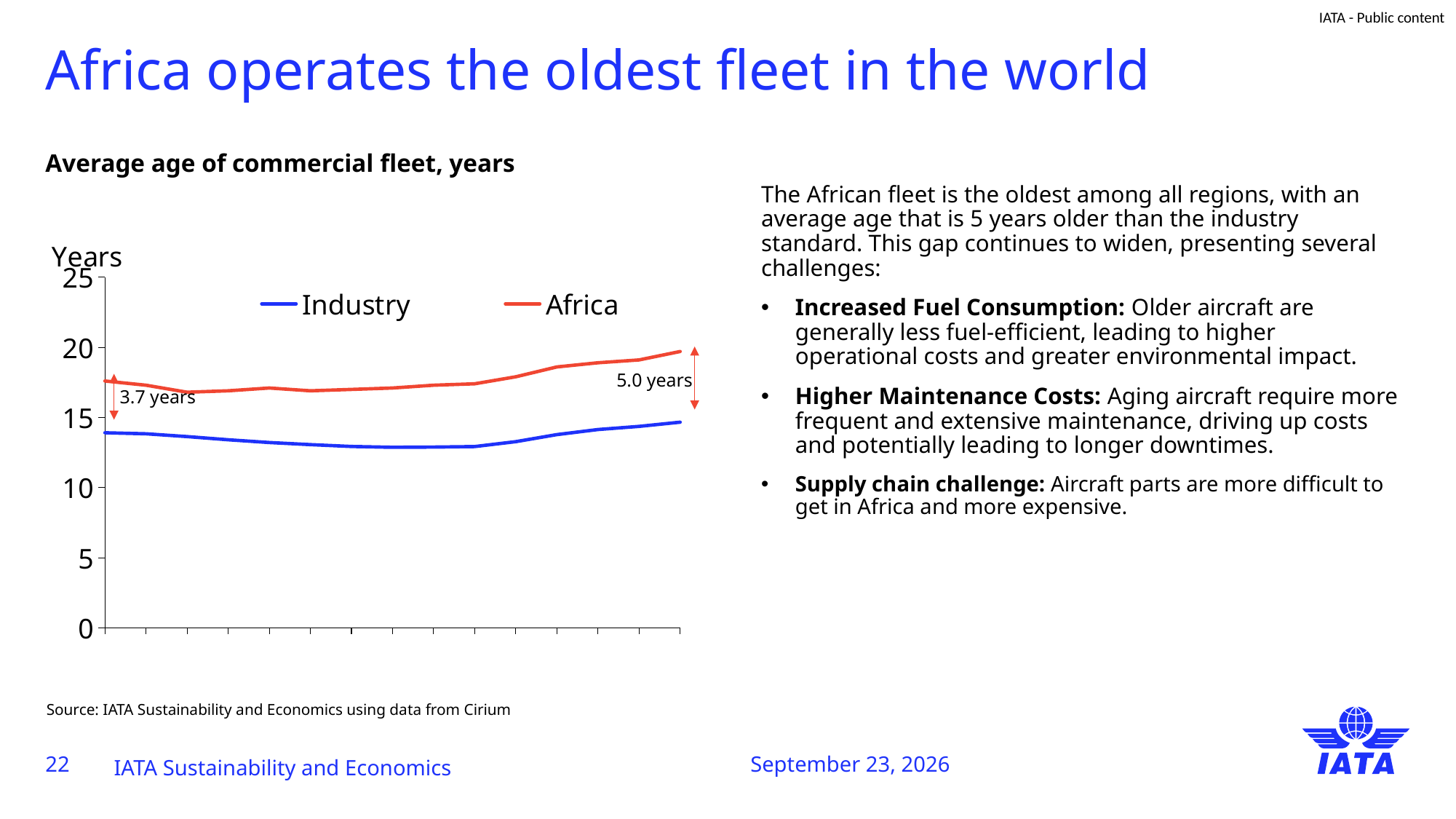
Is the value for Africa at the right end of the chart greater or less than 15? greater Is the lowest point of the Industry line greater or less than 10? greater Is the value for Industry at the left end of the chart greater or less than 15? less According to the annotation at the left of the chart, what is the gap between the Africa and Industry lines at the start of the period? 3.7 years Which series has the higher average fleet age throughout the chart, Industry or Africa? Africa By how much did the annotated gap between Africa and Industry grow from the start (3.7 years) to the end (5.0 years) of the period? 1.3 years Does the Africa line rise or fall from the start to the end of the period? rise What are the two series named in the chart's legend? Industry and Africa What is the title of the chart? Average age of commercial fleet, years How many series does the chart's legend list? 2 According to the annotation at the right of the chart, what is the gap between the Africa and Industry lines at the end of the period? 5.0 years What kind of chart is shown on the slide? line chart